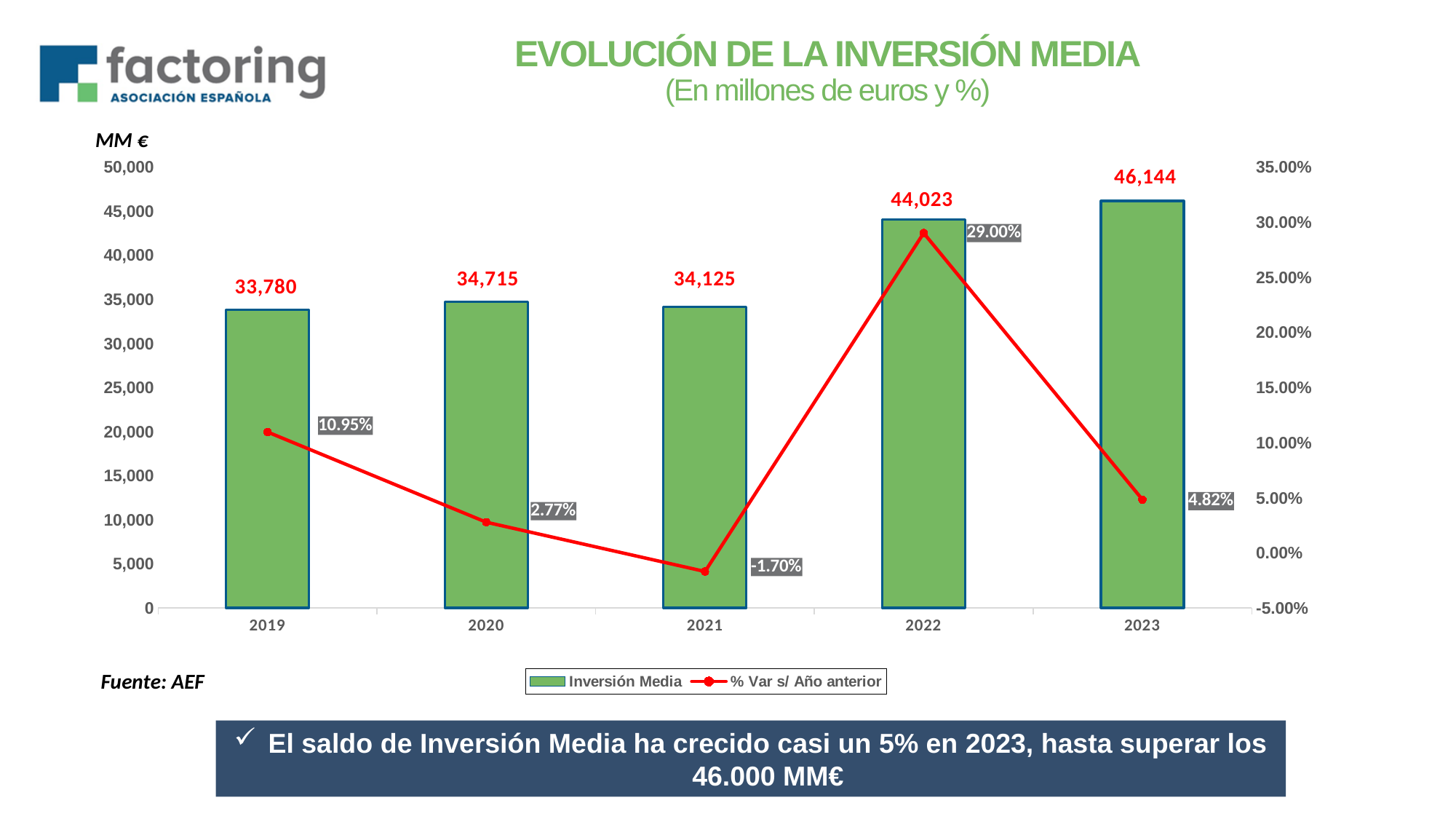
What is the title of the chart? EVOLUCIÓN DE LA INVERSIÓN MEDIA Which year has the highest Inversión Media? 2023 What kind of chart is used to show Inversión Media? Bar chart How many years are shown on the x axis? 5 Which year has the lowest % Var s/ Año anterior? 2021 What is the difference in Inversión Media between 2023 and 2022? 2,121 What is the Inversión Media value for 2023? 46,144 What is the Inversión Media value for 2021? 34,125 Does the Inversión Media rise or fall from 2021 to 2023? Rise Which is larger, the Inversión Media for 2020 or for 2021? 2020 How many series does the legend list? 2 What is the % Var s/ Año anterior value for 2022? 29.00%